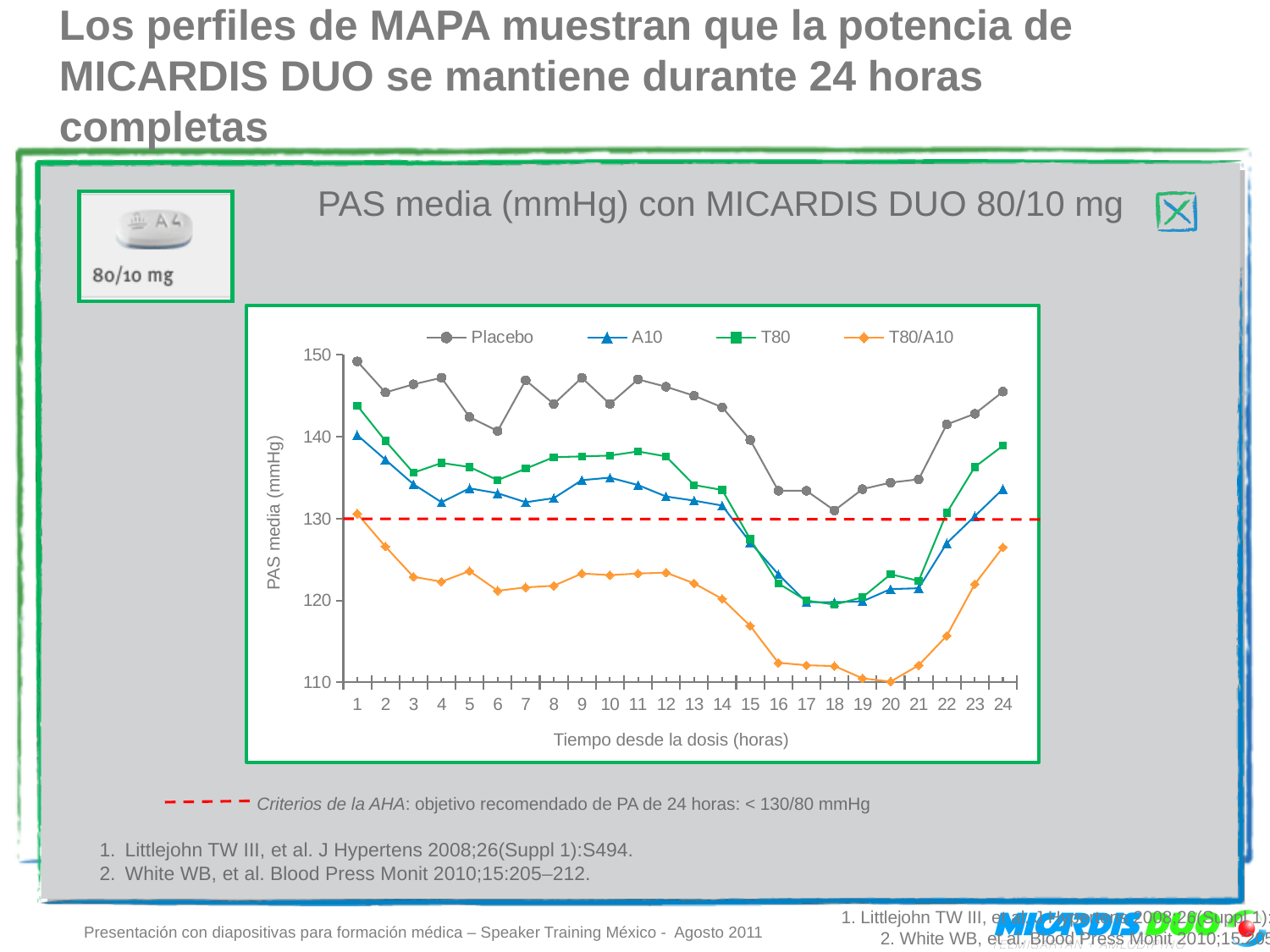
At what PAS media level is the red dashed AHA reference line drawn? 130 Is the T80/A10 value at hour 20 greater or less than 120? less Which series has the lowest PAS media values across the 24 hours? T80/A10 What kind of chart is shown on the slide? line chart Which series has the highest PAS media values across the 24 hours? Placebo Do the T80/A10 values rise or fall from hour 20 to hour 24? rise How many series does the chart legend list? 4 At hour 10, which is larger: the Placebo value or the T80/A10 value? Placebo Is the Placebo value at hour 1 greater or less than 140? greater How many time points (hours) are plotted along the x axis? 24 At hour 1, which is larger: the T80 value or the A10 value? T80 Is the A10 value at hour 18 greater or less than 130? less